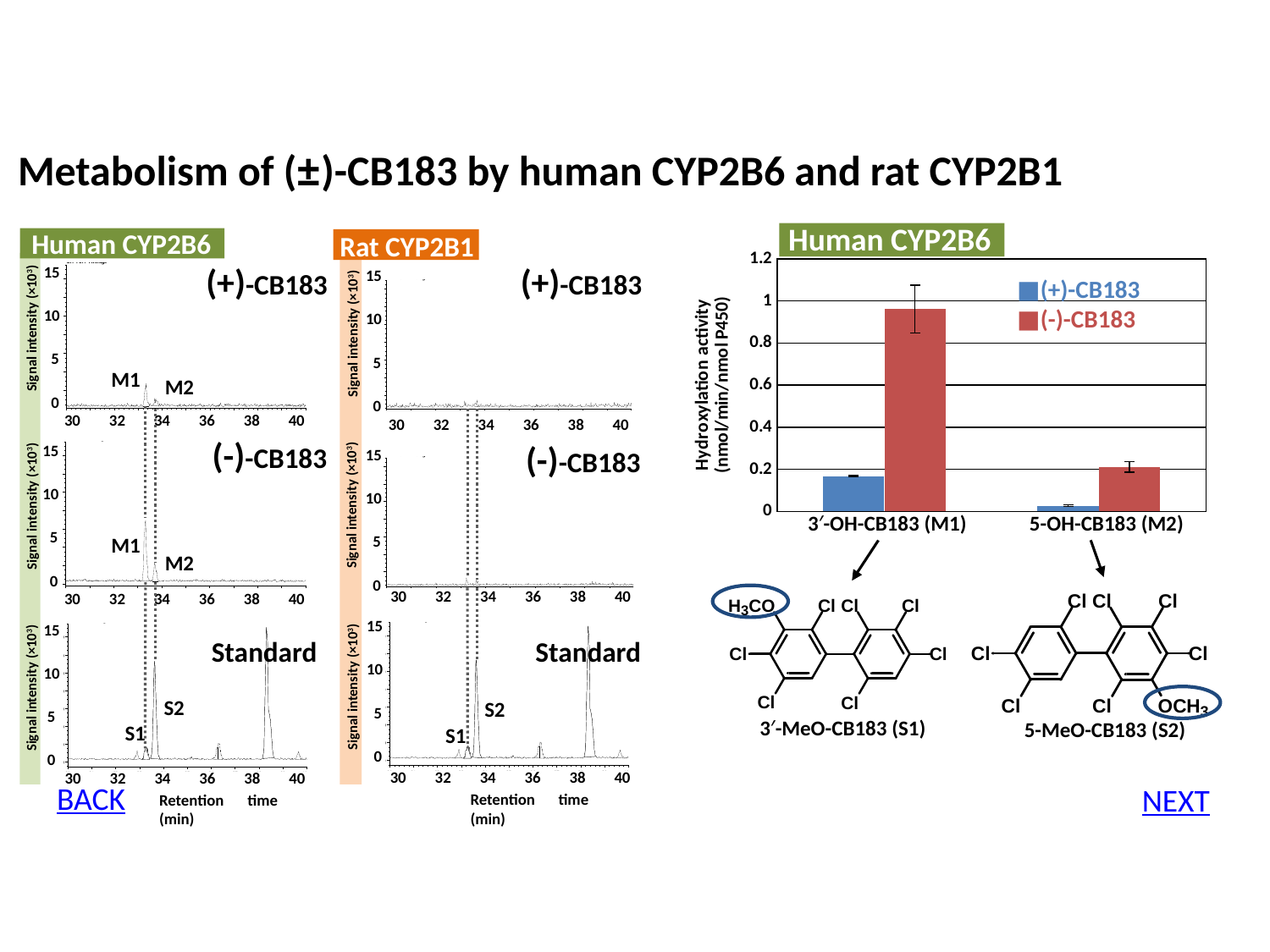
In the 'Human CYP2B6' bar chart, is the value for (+)-CB183 at 3′-OH-CB183 (M1) greater or less than 0.2? less In the 'Human CYP2B6' bar chart, is the value for (-)-CB183 at 5-OH-CB183 (M2) greater or less than 0.4? less In the 'Human CYP2B6' bar chart, which bar is the highest? (-)-CB183 for 3′-OH-CB183 (M1) In the 'Human CYP2B6' bar chart, which is larger for 3′-OH-CB183 (M1): (+)-CB183 or (-)-CB183? (-)-CB183 In the 'Human CYP2B6' bar chart, which bar is the lowest? (+)-CB183 for 5-OH-CB183 (M2) In the 'Human CYP2B6' bar chart, is the value for (-)-CB183 at 3′-OH-CB183 (M1) greater or less than 0.8? greater What kind of chart is the 'Human CYP2B6' chart on the right of the slide? bar chart In the 'Human CYP2B6' bar chart, how many series does the legend list? 2 In the 'Human CYP2B6' bar chart, what is the label of the y axis? Hydroxylation activity (nmol/min/nmol P450) In the 'Human CYP2B6' bar chart, how many categories are shown on the x axis? 2 In the 'Human CYP2B6' bar chart, what colour are the (-)-CB183 bars? red In the 'Human CYP2B6' bar chart, which series is larger for 5-OH-CB183 (M2)? (-)-CB183